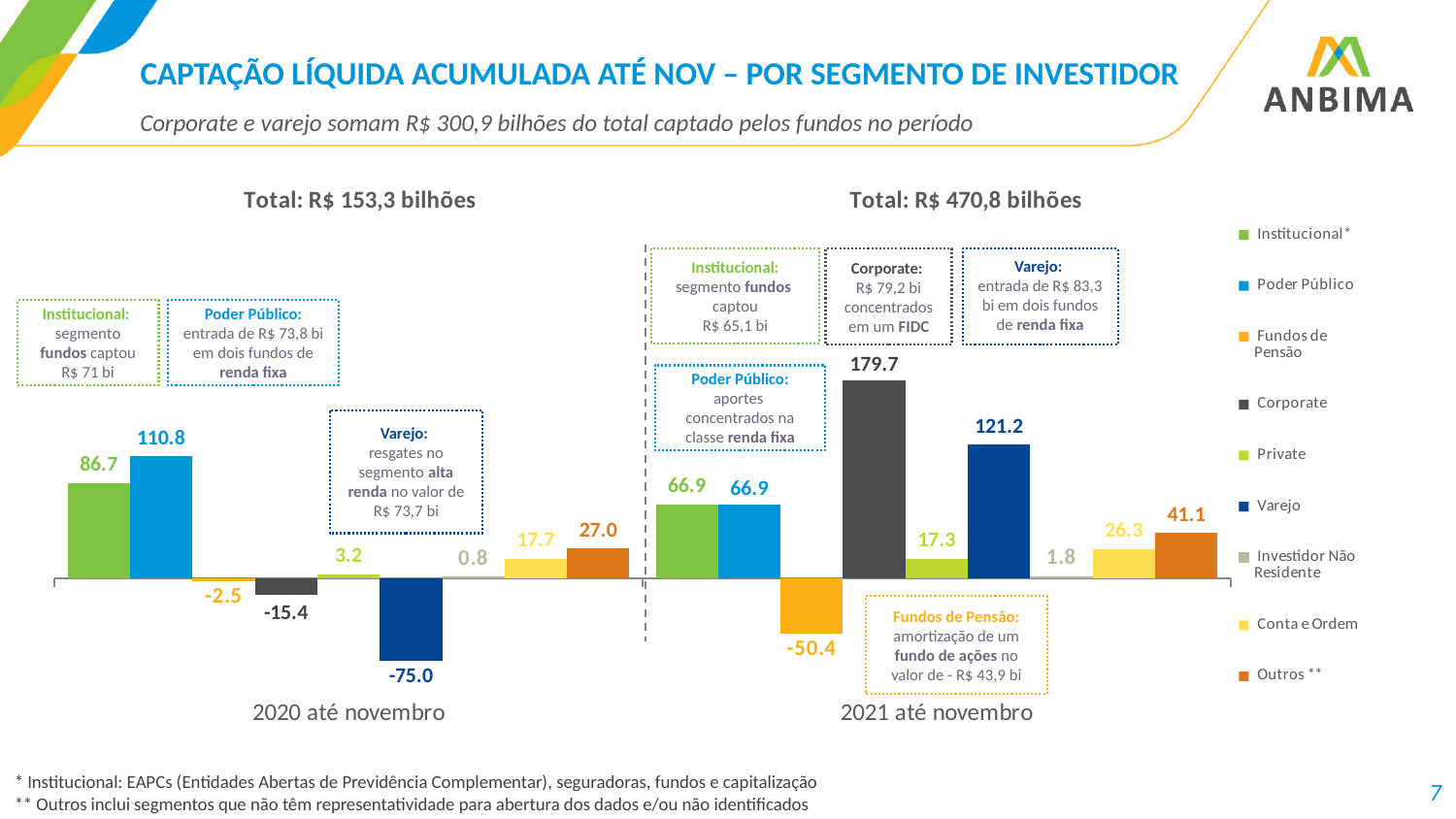
What is the value for Conta e Ordem in 2020 até novembro? 17.7 What type of chart is shown on the slide? Bar chart What is the value for Fundos de Pensão in 2021 até novembro? -50.4 Which segment has the lowest value in 2021 até novembro? Fundos de Pensão What is the value for Varejo in 2020 até novembro? -75.0 How many series does the legend list? 9 What is the difference between the Varejo values for 2021 até novembro and 2020 até novembro? 196.2 What is the total shown for 2021 até novembro? R$ 470,8 bilhões What is the value for Corporate in 2021 até novembro? 179.7 Which segment has the highest value in 2020 até novembro? Poder Público Which is larger: Institucional in 2020 até novembro or Institucional in 2021 até novembro? 2020 até novembro What is the title of the chart? CAPTAÇÃO LÍQUIDA ACUMULADA ATÉ NOV – POR SEGMENTO DE INVESTIDOR